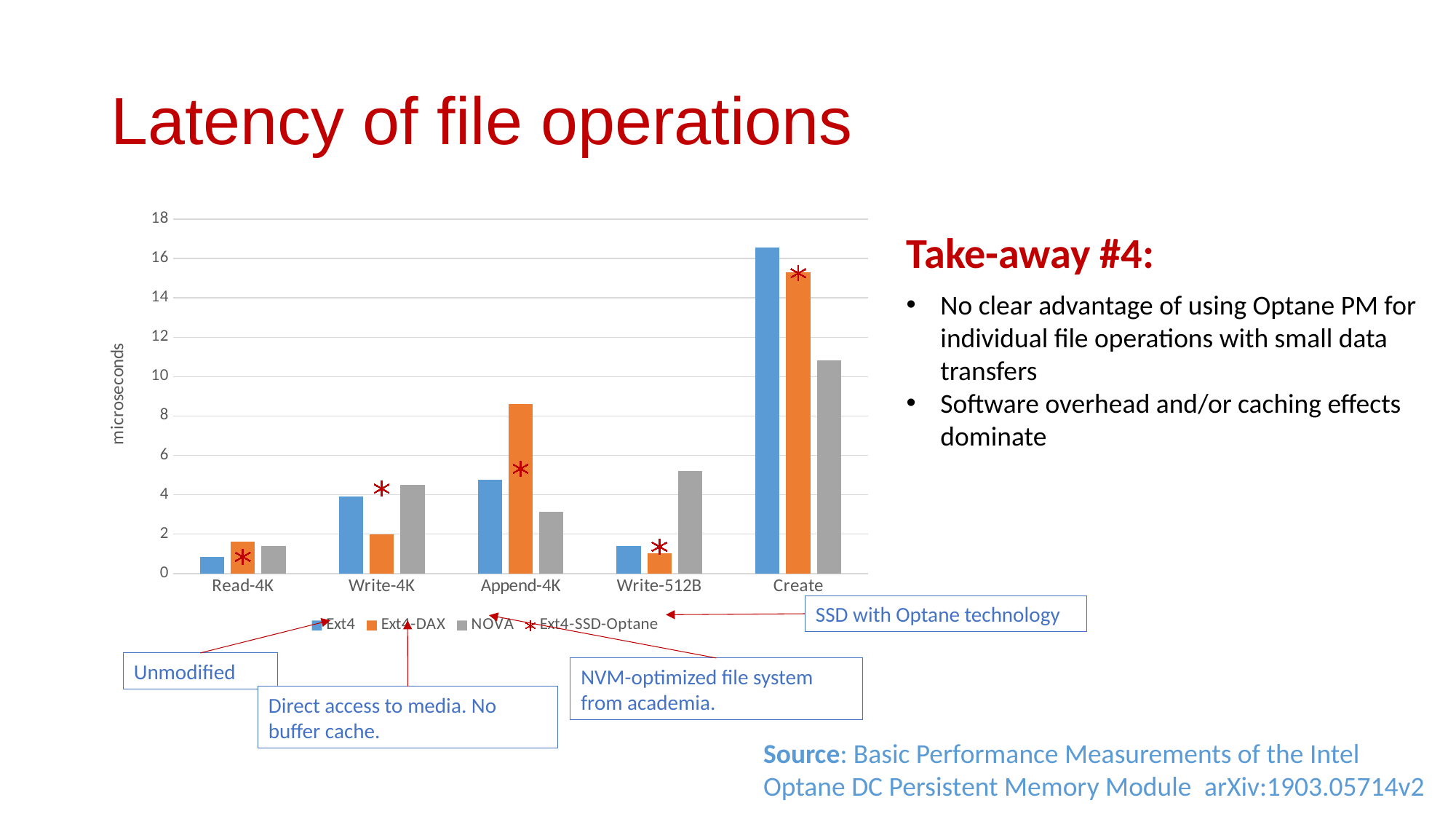
Is the Ext4-DAX value for Write-4K greater or less than 4? less For Append-4K, which is larger: the Ext4-DAX bar or the NOVA bar? Ext4-DAX What unit is shown on the y axis of the chart? microseconds Which category has the highest Ext4 bar? Create How many file operation categories are shown on the x axis of the chart? 5 How many series does the chart legend list? 4 For Write-4K, which is larger: the Ext4 bar or the Ext4-DAX bar? Ext4 What kind of chart is shown on the slide? bar chart Which series has the lowest bar for Read-4K? Ext4 Is the NOVA value for Write-512B greater or less than 4? greater Is the Ext4-DAX value for Append-4K greater or less than 8? greater